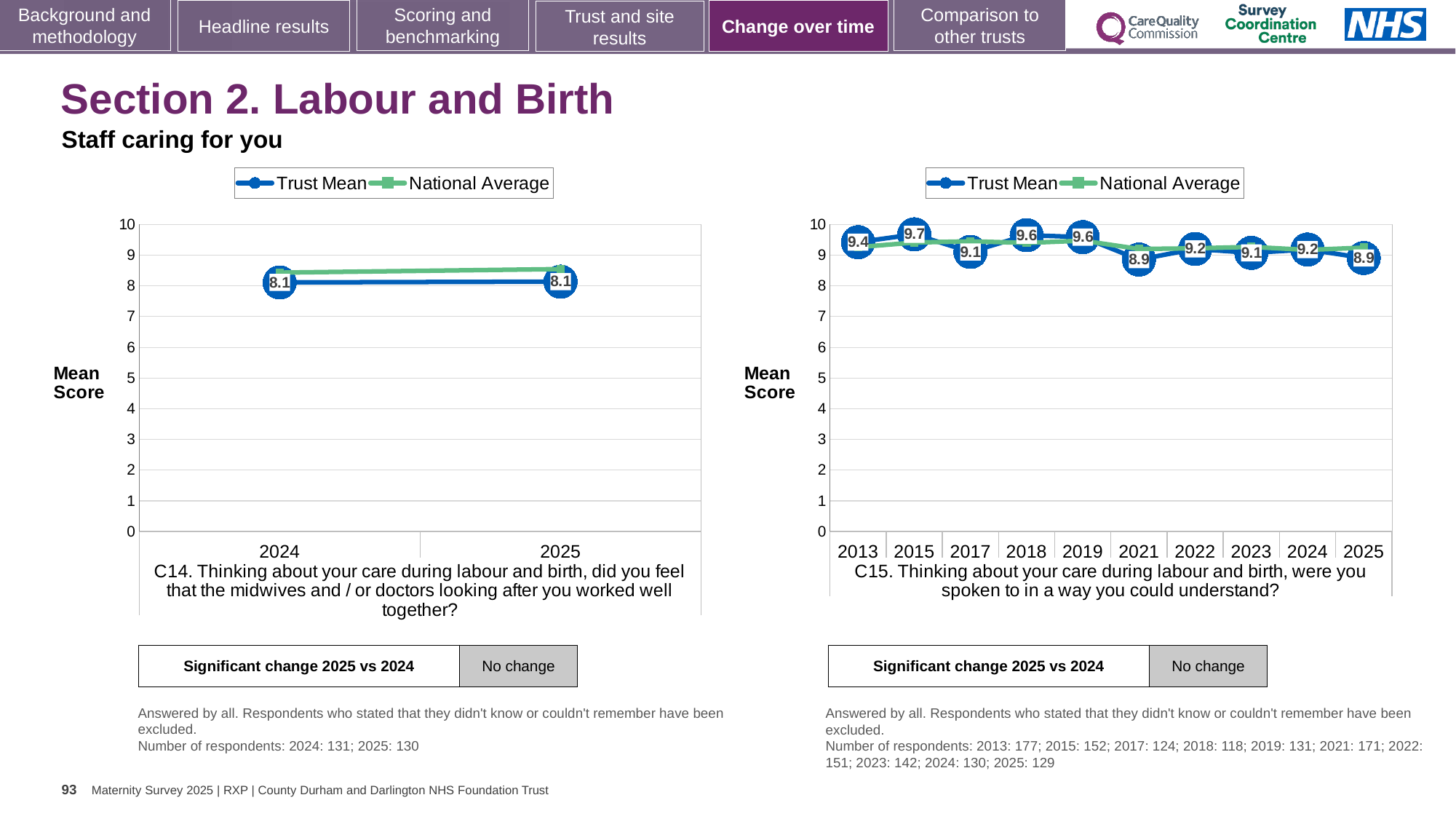
In the left chart (C14), is the National Average for 2025 greater or less than 8? greater In the right chart (C15), what is the difference between the Trust Mean in 2013 and the Trust Mean in 2025? 0.5 In the left chart (C14), what is the Trust Mean for 2024? 8.1 In the right chart (C15), how many years are shown on the x axis? 10 In the right chart (C15), which year has the highest Trust Mean? 2015 In the left chart (C14), what is the Trust Mean for 2025? 8.1 What type of chart is the right chart (C15)? Line chart In the right chart (C15), what is the Trust Mean for 2015? 9.7 In the right chart (C15), is the Trust Mean higher in 2018 or in 2023? 2018 In the right chart (C15), what is the difference between the Trust Mean in 2015 and the Trust Mean in 2017? 0.6 In the left chart (C14), how many series does the legend list? 2 In the right chart (C15), what is the Trust Mean for 2021? 8.9